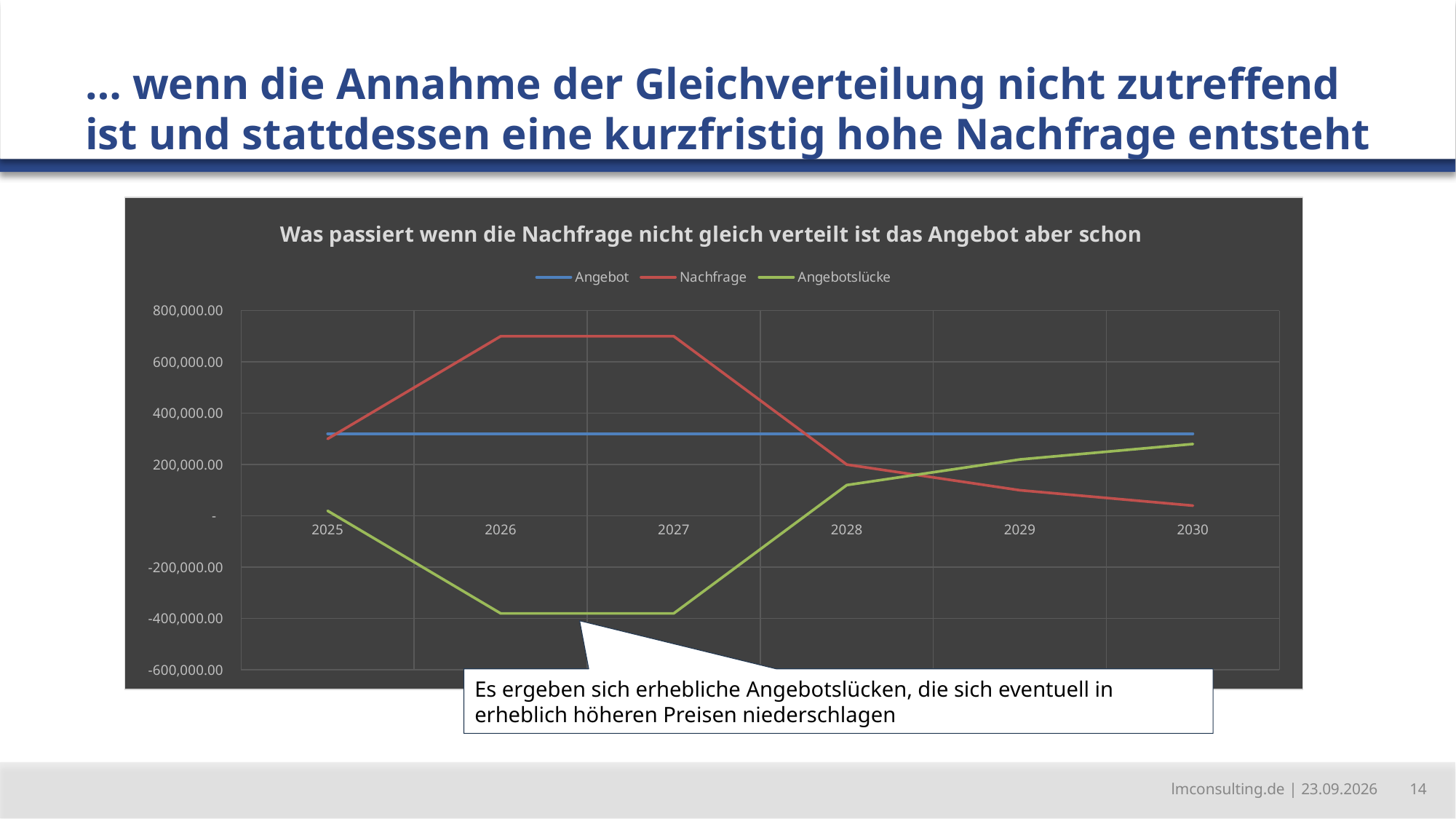
How many series does the legend list? 3 Is the value for Nachfrage in 2026 greater or less than 600,000.00? greater Does the Angebot line rise, fall or stay flat from 2025 to 2030? stays flat In 2030, which is larger: Angebot or Nachfrage? Angebot Is the value for Angebotslücke in 2026 greater or less than -200,000.00? less How many years are shown on the x axis? 6 In which year is the Nachfrage value lowest? 2030 Does the Angebotslücke line rise or fall from 2027 to 2030? rises In 2026, which is larger: Nachfrage or Angebot? Nachfrage Is the value for Nachfrage in 2030 greater or less than 200,000.00? less What kind of chart is shown on the slide? line chart